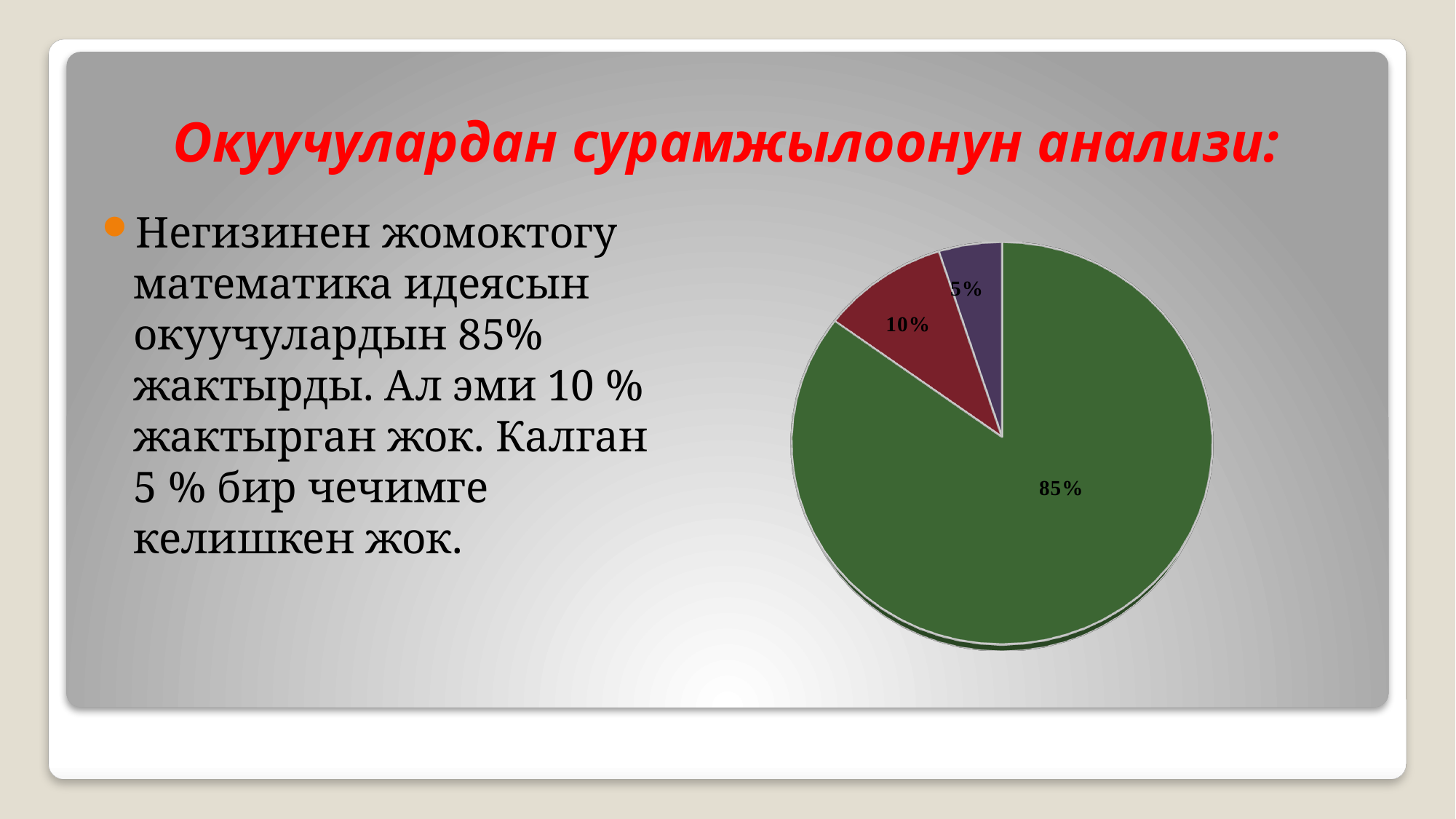
What percentage is shown on the purple slice of the pie chart? 5% What percentage is shown on the green slice of the pie chart? 85% Which slice is larger in the pie chart, the dark red one or the purple one? the dark red one What kind of chart is shown on the slide? pie chart What is the value of the largest slice of the pie chart? 85% What percentage is shown on the dark red slice of the pie chart? 10% What is the difference between the green slice and the dark red slice of the pie chart? 75% What is the difference between the dark red slice and the purple slice of the pie chart? 5% What is the value of the smallest slice of the pie chart? 5% How many slices does the pie chart have? 3 What do the three slices of the pie chart add up to? 100% What colour is the largest slice of the pie chart? green